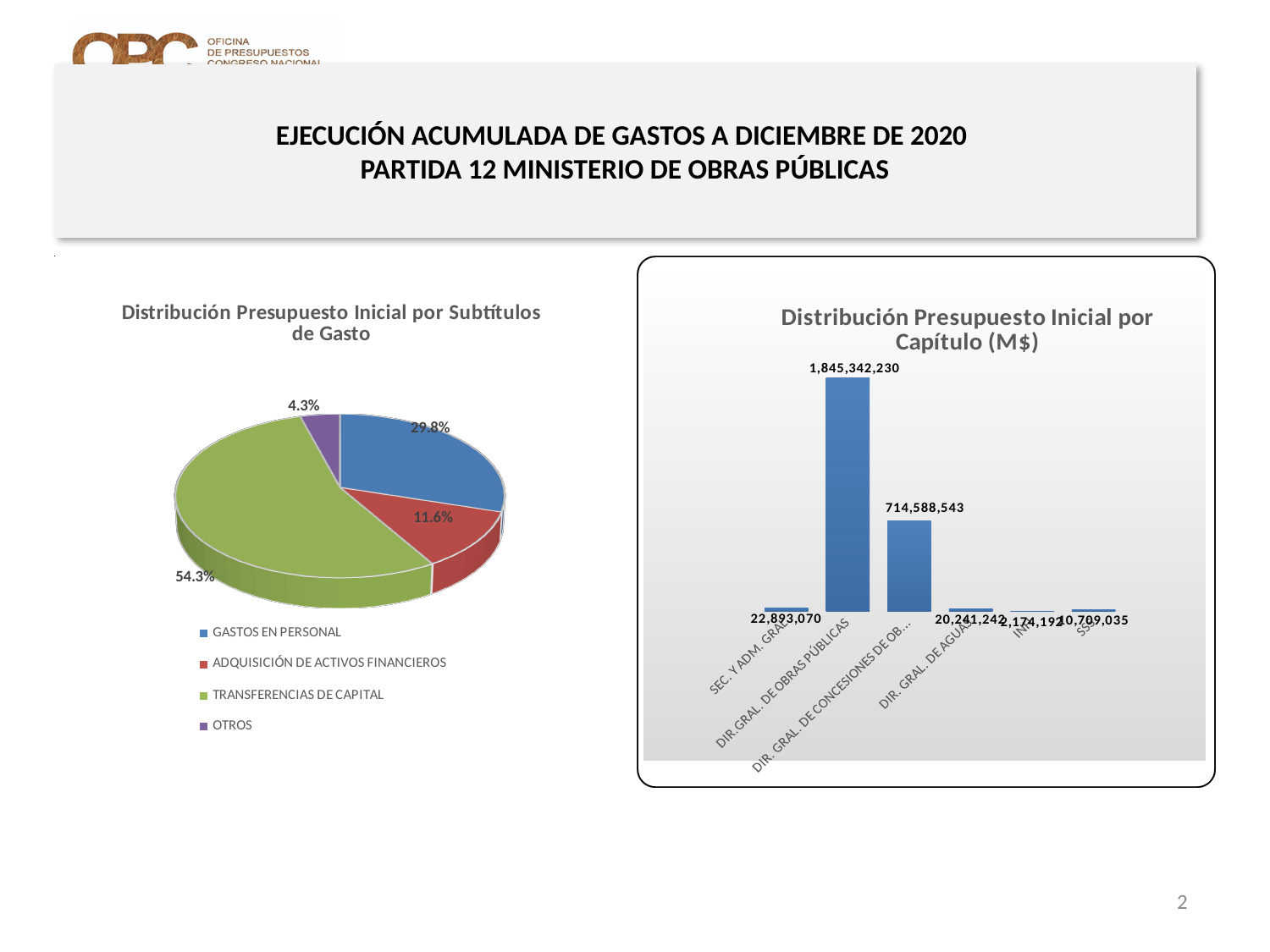
In the pie chart 'Distribución Presupuesto Inicial por Subtítulos de Gasto', what percentage is shown for GASTOS EN PERSONAL? 29.8% In the pie chart 'Distribución Presupuesto Inicial por Subtítulos de Gasto', what share does TRANSFERENCIAS DE CAPITAL have? 54.3% In the bar chart 'Distribución Presupuesto Inicial por Capítulo (M$)', what is the value for DIR. GRAL. DE AGUAS? 20,241,242 In the bar chart 'Distribución Presupuesto Inicial por Capítulo (M$)', what is the value for DIR.GRAL. DE OBRAS PÚBLICAS? 1,845,342,230 In the pie chart on the left, what is the difference in percentage points between TRANSFERENCIAS DE CAPITAL and GASTOS EN PERSONAL? 24.5% In the bar chart on the right, what is the difference between DIR.GRAL. DE OBRAS PÚBLICAS (1,845,342,230) and DIR. GRAL. DE CONCESIONES DE OB... (714,588,543)? 1,130,753,687 What kind of chart is 'Distribución Presupuesto Inicial por Capítulo (M$)'? Bar chart In the pie chart on the left, which category has the smallest slice? OTROS How many slices does the pie chart 'Distribución Presupuesto Inicial por Subtítulos de Gasto' have? 4 In the pie chart on the left, which category has the largest slice? TRANSFERENCIAS DE CAPITAL In the bar chart on the right, which is larger: SEC. Y ADM. GRAL. or DIR. GRAL. DE AGUAS? SEC. Y ADM. GRAL. In the bar chart on the right, which capítulo has the highest value? DIR.GRAL. DE OBRAS PÚBLICAS